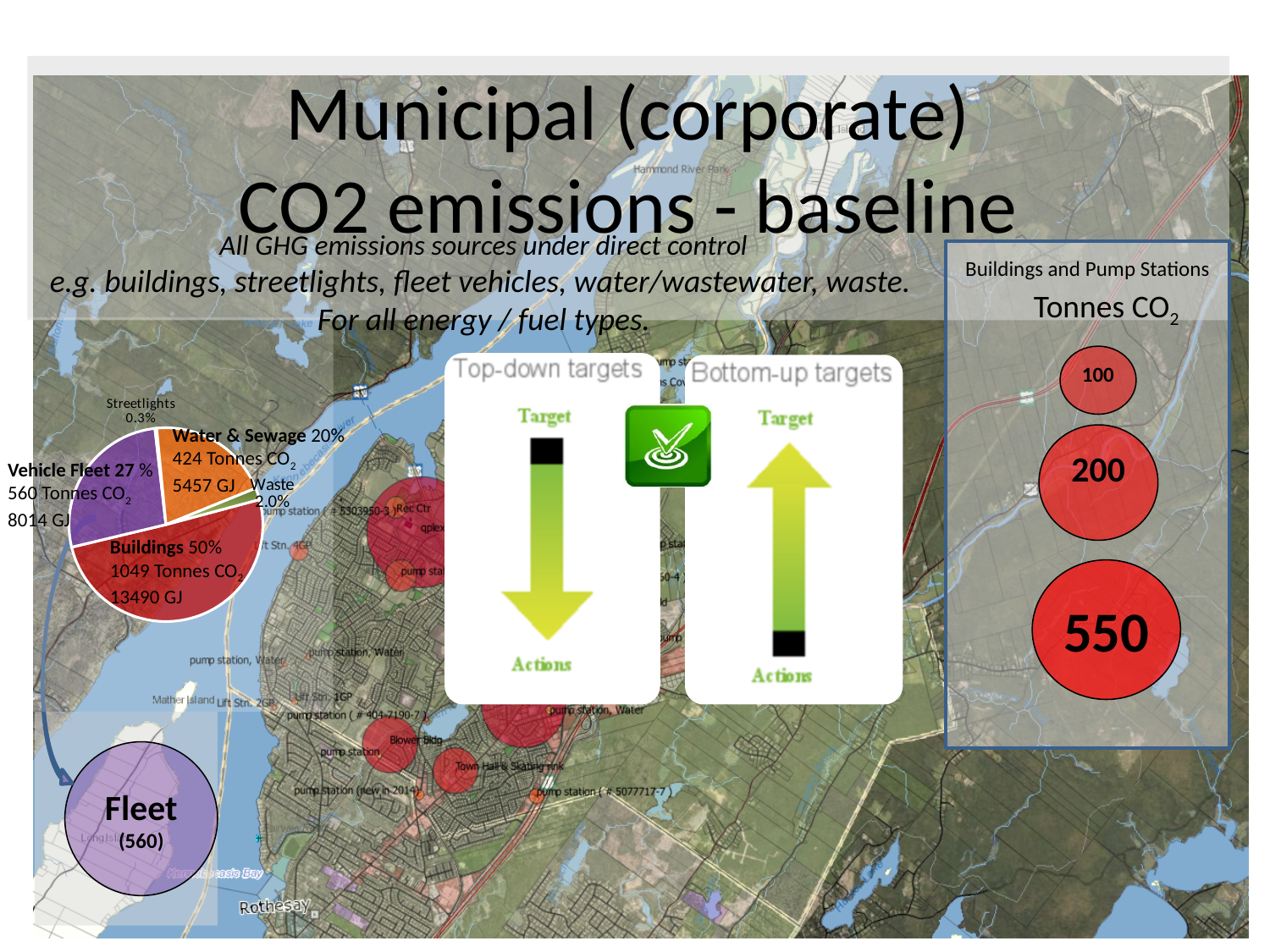
In the pie chart, what share of emissions comes from Water & Sewage? 20% Which category in the pie chart has the largest share? Buildings In the pie chart, how many tonnes of CO2 are attributed to Water & Sewage? 424 Tonnes CO2 What type of chart is shown on the left of the slide? pie chart In the pie chart, how many tonnes of CO2 are attributed to Buildings? 1049 Tonnes CO2 In the pie chart, what share of emissions comes from Waste? 2.0% In the pie chart, what share of emissions comes from Buildings? 50% Which category in the pie chart has the smallest share? Streetlights In the pie chart, how many GJ are attributed to Vehicle Fleet? 8014 GJ How many categories does the pie chart show? 5